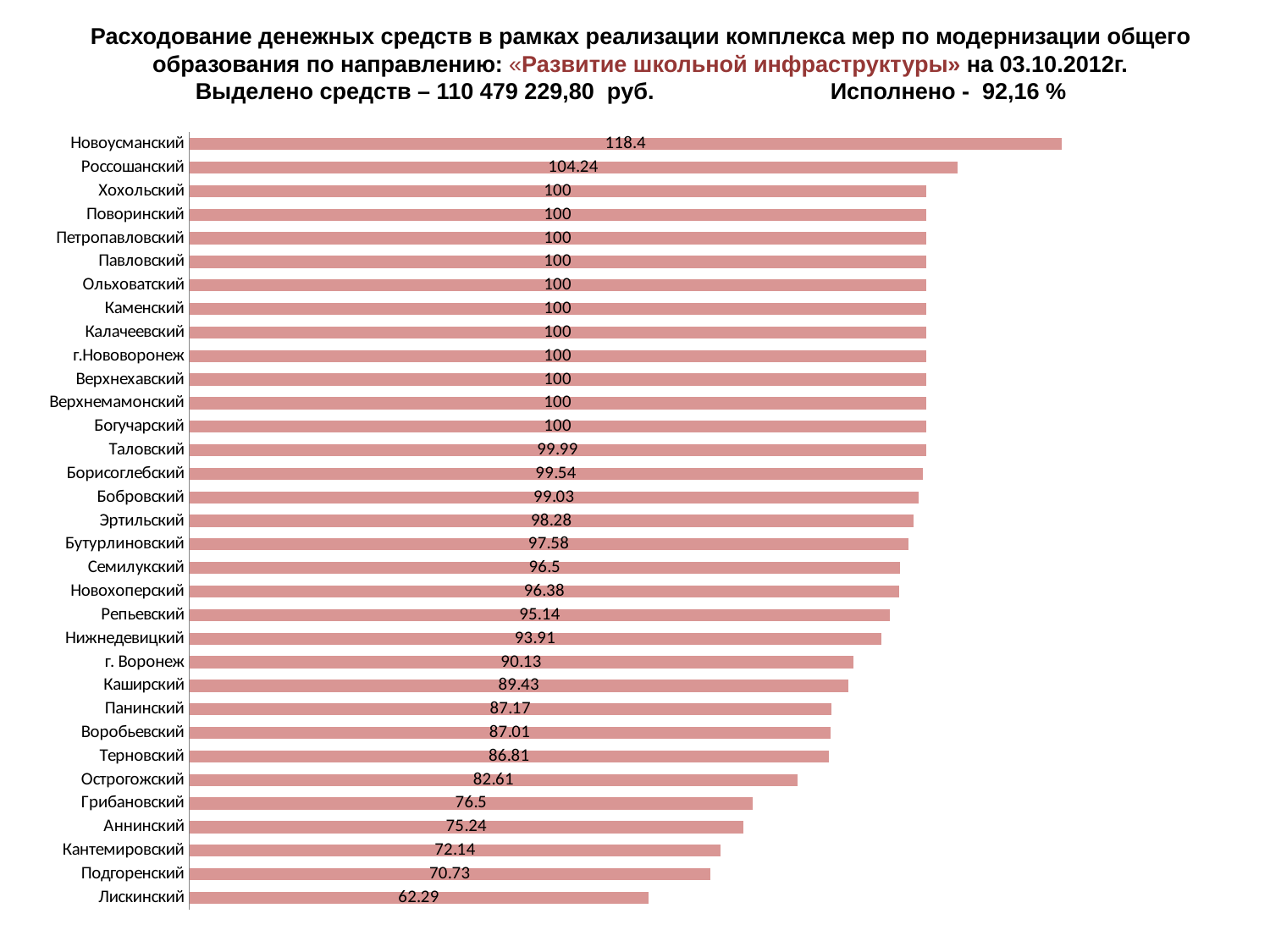
How many categories have a value of exactly 100? 11 Which category has the lowest value? Лискинский What is the value for г. Воронеж? 90.13 Which category has the highest value? Новоусманский Which is larger, the value for Грибановский or the value for Аннинский? Грибановский What is the value for Новоусманский? 118.4 How many categories are shown in the chart? 33 What is the value for Острогожский? 82.61 What is the value for Лискинский? 62.29 What is the difference between the values for Новоусманский and Россошанский? 14.16 What is the difference between the values for Подгоренский and Лискинский? 8.44 What kind of chart is shown on the slide? Bar chart